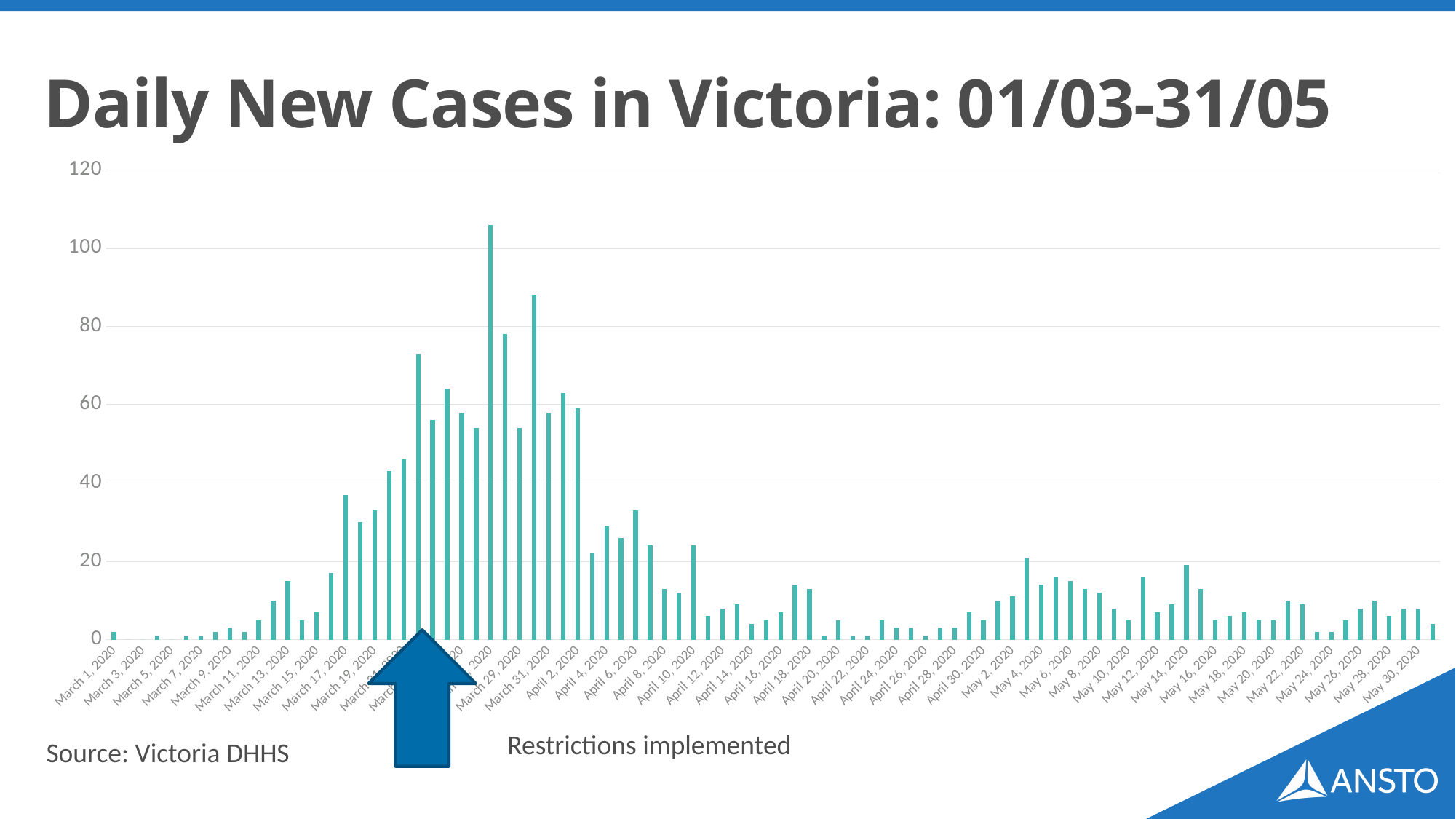
Is the highest daily value on the chart greater or less than 100? greater From March 1, 2020 to late March 2020, do the daily values generally rise or fall? rise From the peak in late March to the end of May, do the daily values generally rise or fall? fall Is the value for April 4, 2020 greater or less than 10? greater Is the value for May 4, 2020 greater or less than 40? less What event does the arrow annotation below the chart mark? Restrictions implemented Which has the larger value, March 1, 2020 or March 17, 2020? March 17, 2020 What is the title of the chart? Daily New Cases in Victoria: 01/03-31/05 What kind of chart is shown on the slide? bar chart